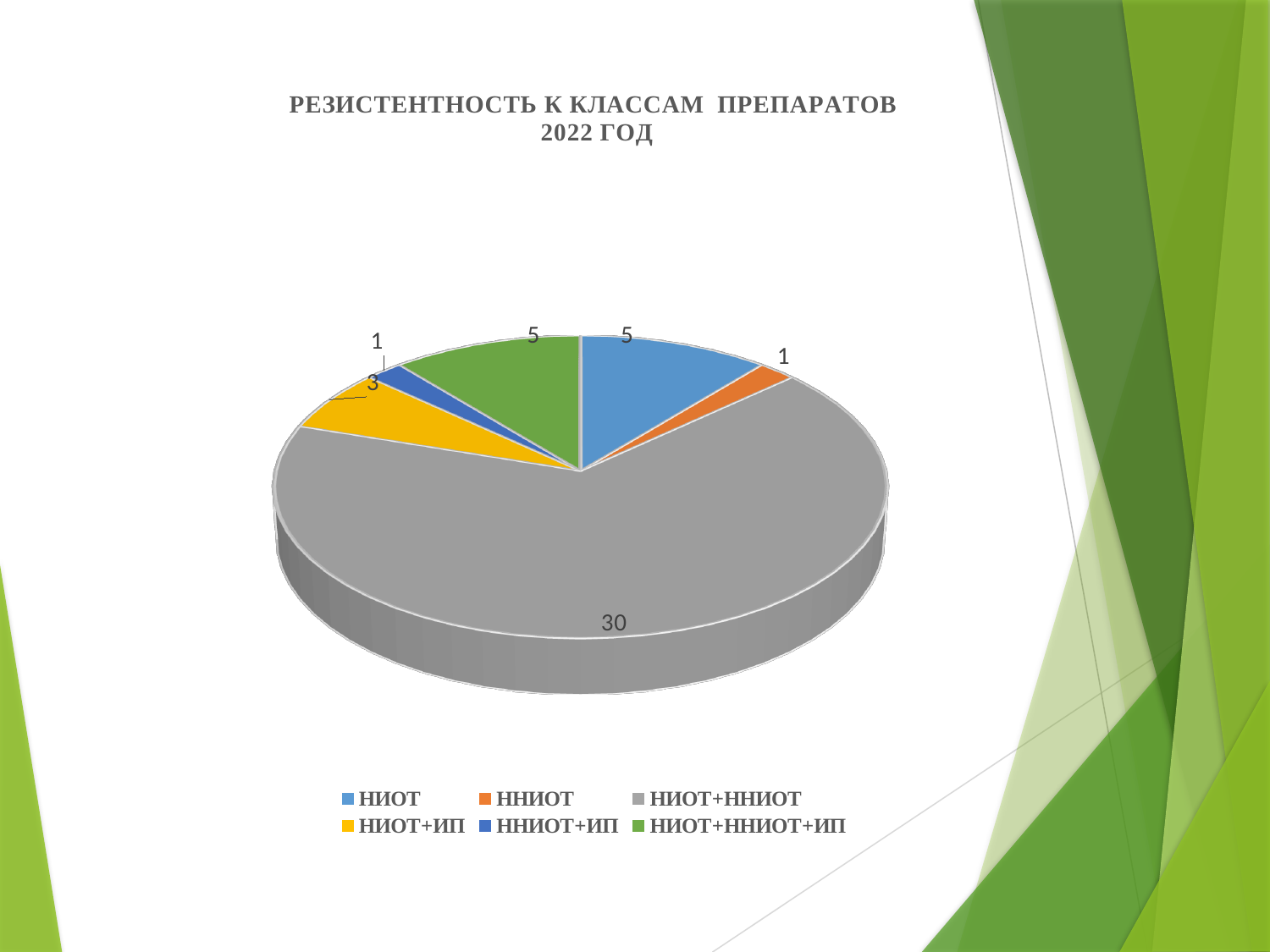
What is the value for НИОТ+ННИОТ+ИП? 5 What is the total of all slices in the pie chart? 45 What is the title of the chart? РЕЗИСТЕНТНОСТЬ К КЛАССАМ ПРЕПАРАТОВ 2022 ГОД Which is larger, the value for НИОТ+ИП or the value for ННИОТ+ИП? НИОТ+ИП How many categories does the pie chart have? 6 What kind of chart is shown on the slide? pie chart What is the value for НИОТ? 5 Which category has the largest slice? НИОТ+ННИОТ What is the value for НИОТ+ИП? 3 What is the value for ННИОТ? 1 What is the value for НИОТ+ННИОТ? 30 What is the difference between the values for НИОТ+ННИОТ and НИОТ? 25